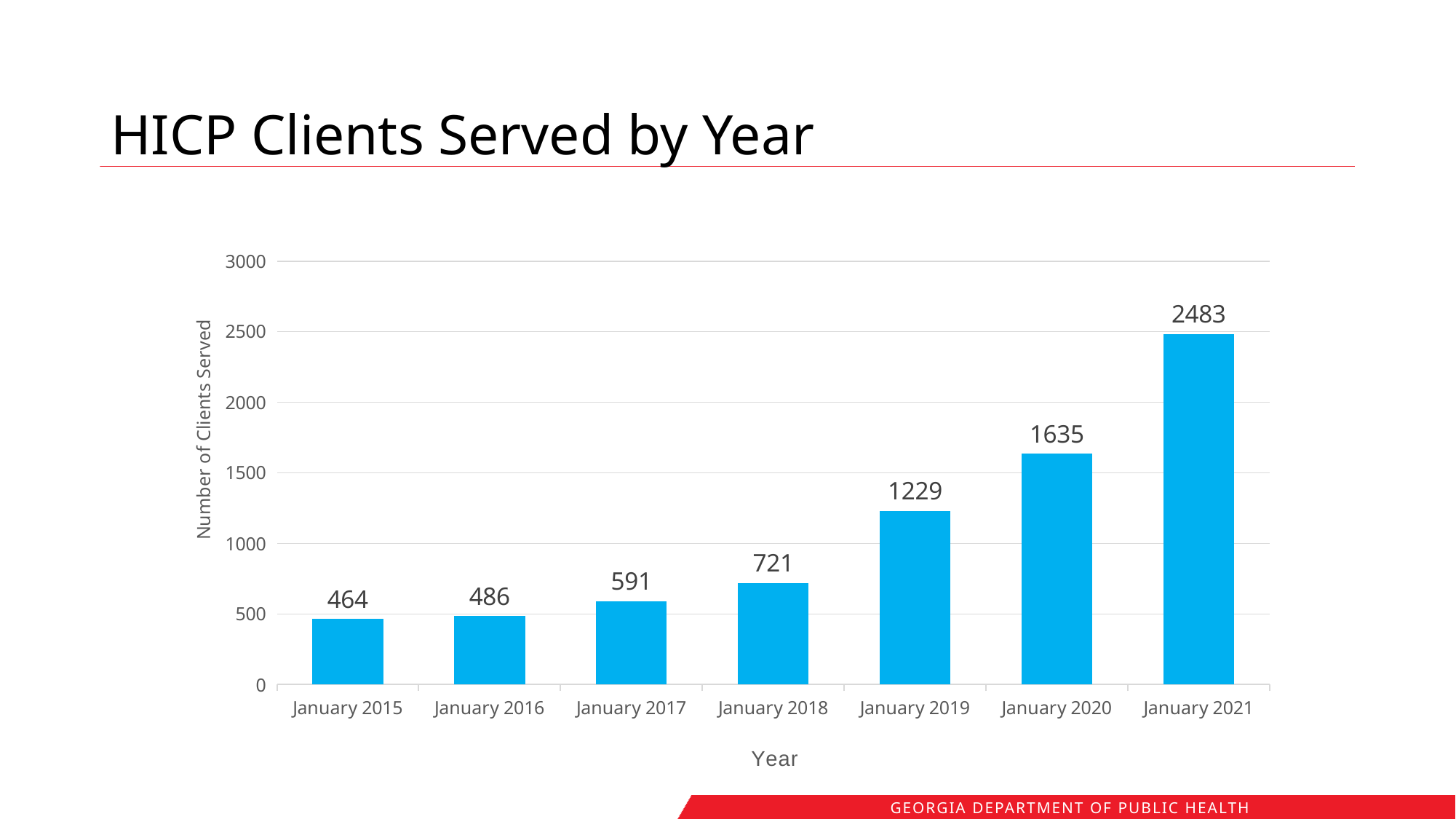
What is the number of clients served in January 2015? 464 What is the number of clients served in January 2018? 721 How many years are shown on the chart? 7 What is the number of clients served in January 2021? 2483 What kind of chart is shown on the slide? Bar chart Which year has the lowest number of clients served? January 2015 Is the value for January 2020 greater or less than 1500? greater What is the difference in clients served between January 2019 and January 2018? 508 What is the difference in clients served between January 2021 and January 2020? 848 Do the values rise or fall from January 2015 to January 2021? Rise Which year has the highest number of clients served? January 2021 Which is larger, the number of clients served in January 2017 or January 2016? January 2017